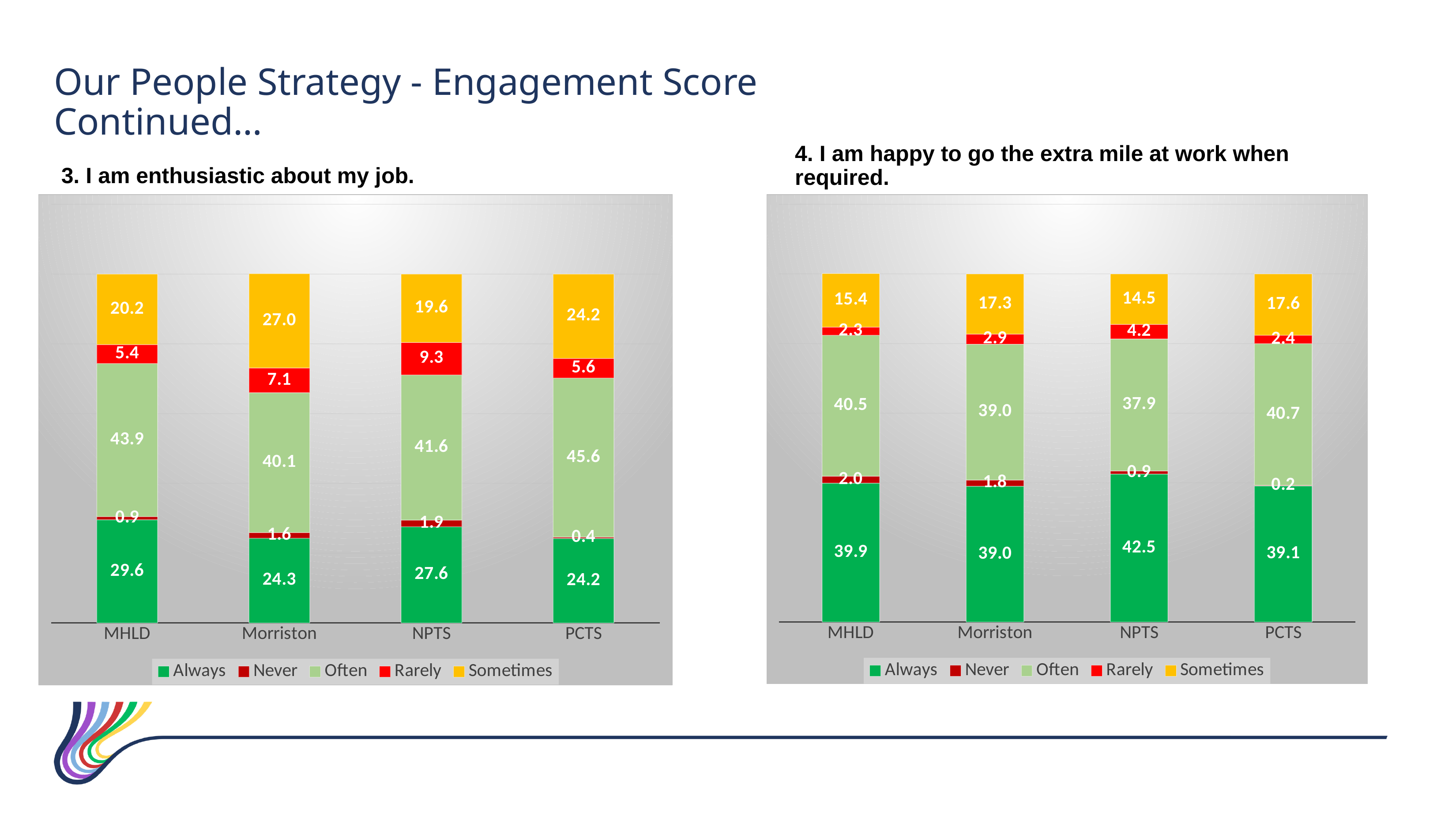
In the chart for "3. I am enthusiastic about my job.", which category has the lowest Never value? PCTS In the chart for "4. I am happy to go the extra mile at work when required.", what is the Always value for NPTS? 42.5 In the chart for "4. I am happy to go the extra mile at work when required.", which category has the highest Sometimes value? PCTS In the chart for "3. I am enthusiastic about my job.", which category has the highest Rarely value? NPTS In the chart for "4. I am happy to go the extra mile at work when required.", what is the difference between the Always values for NPTS and Morriston? 3.5 In the chart for "3. I am enthusiastic about my job.", what is the Always value for MHLD? 29.6 What kind of chart is used for "4. I am happy to go the extra mile at work when required."? Stacked bar chart In the chart for "3. I am enthusiastic about my job.", what is the difference between the Often values for PCTS and Morriston? 5.5 How many series does the legend list in the chart for "3. I am enthusiastic about my job."? 5 In the chart for "3. I am enthusiastic about my job.", what is the Sometimes value for Morriston? 27.0 In the chart for "4. I am happy to go the extra mile at work when required.", is the Often value larger for MHLD or NPTS? MHLD In the chart for "4. I am happy to go the extra mile at work when required.", what is the Rarely value for Morriston? 2.9